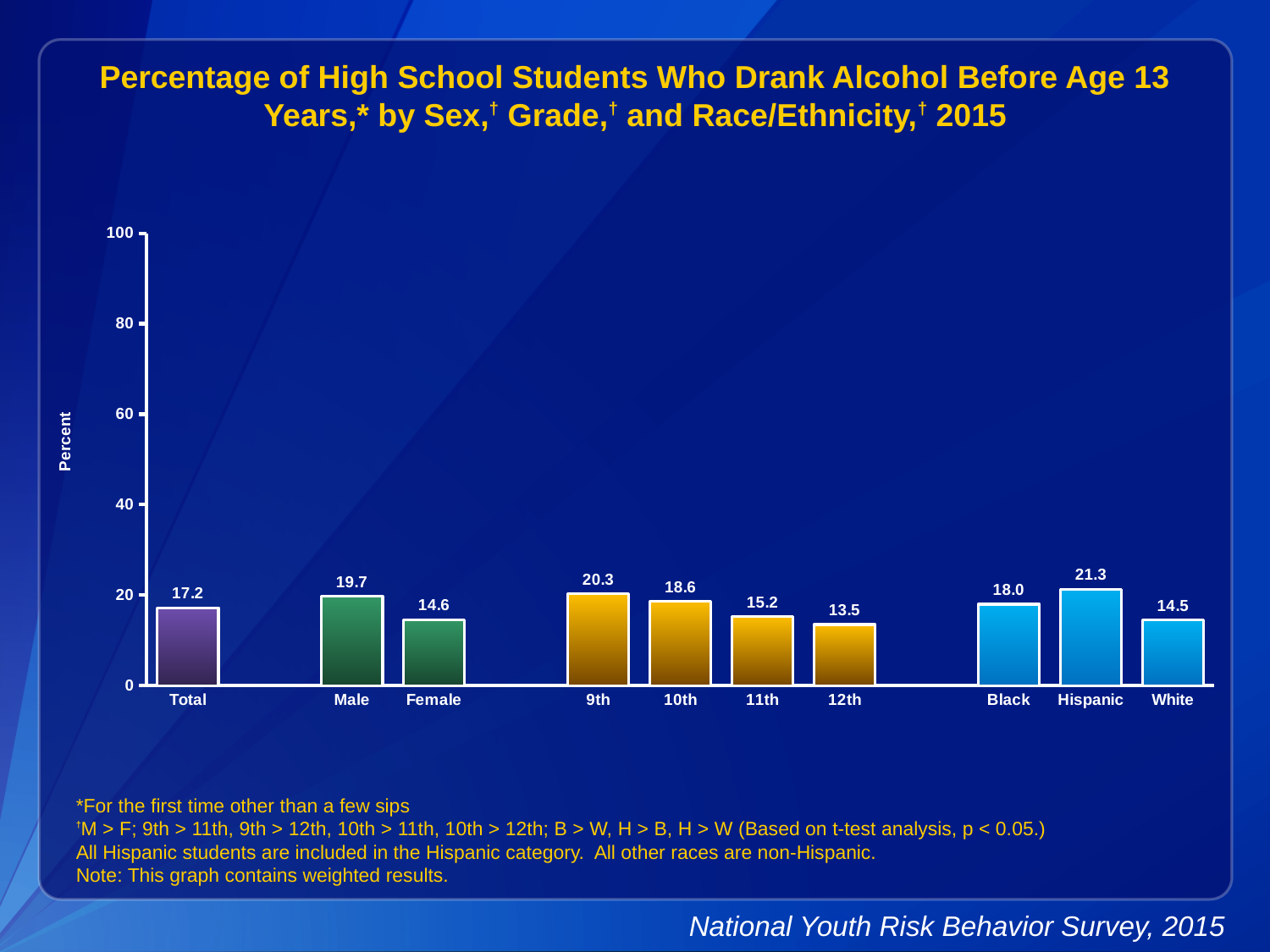
What is the label of the y axis? Percent Is the value for Black students greater or less than 20? less What is the value for Total? 17.2 Which category has the highest value? Hispanic Which is larger, the value for 9th grade or the value for 10th grade? 9th What kind of chart is shown? bar chart What is the difference between the values for Male and Female? 5.1 What is the value for 12th grade? 13.5 Do the values rise or fall from 9th grade to 12th grade? fall What is the value for Hispanic students? 21.3 Which category has the lowest value? 12th How many bars are shown in the chart? 10